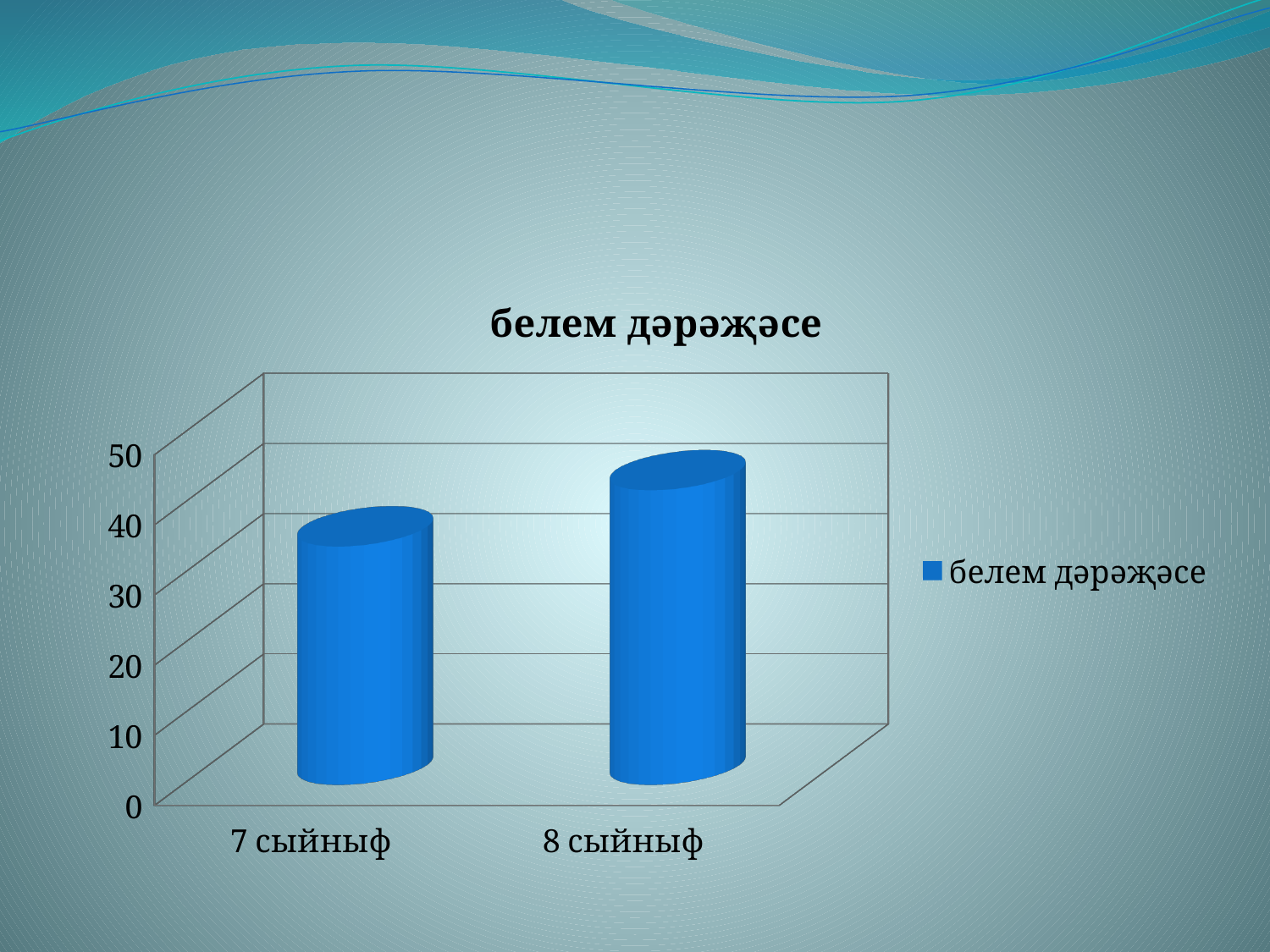
Which is larger, the value for 7 сыйныф or the value for 8 сыйныф? 8 сыйныф What is the name of the series shown in the legend? белем дәрәҗәсе Is the value for 7 сыйныф greater or less than 20? greater Which category has the highest value? 8 сыйныф What is the title of the chart? белем дәрәҗәсе How many categories are shown on the x axis of the chart? 2 Which category has the lowest value? 7 сыйныф What kind of chart is shown on the slide? bar chart How many series does the legend list? 1 Do the values rise or fall from 7 сыйныф to 8 сыйныф? rise Is the value for 7 сыйныф greater or less than 30? greater